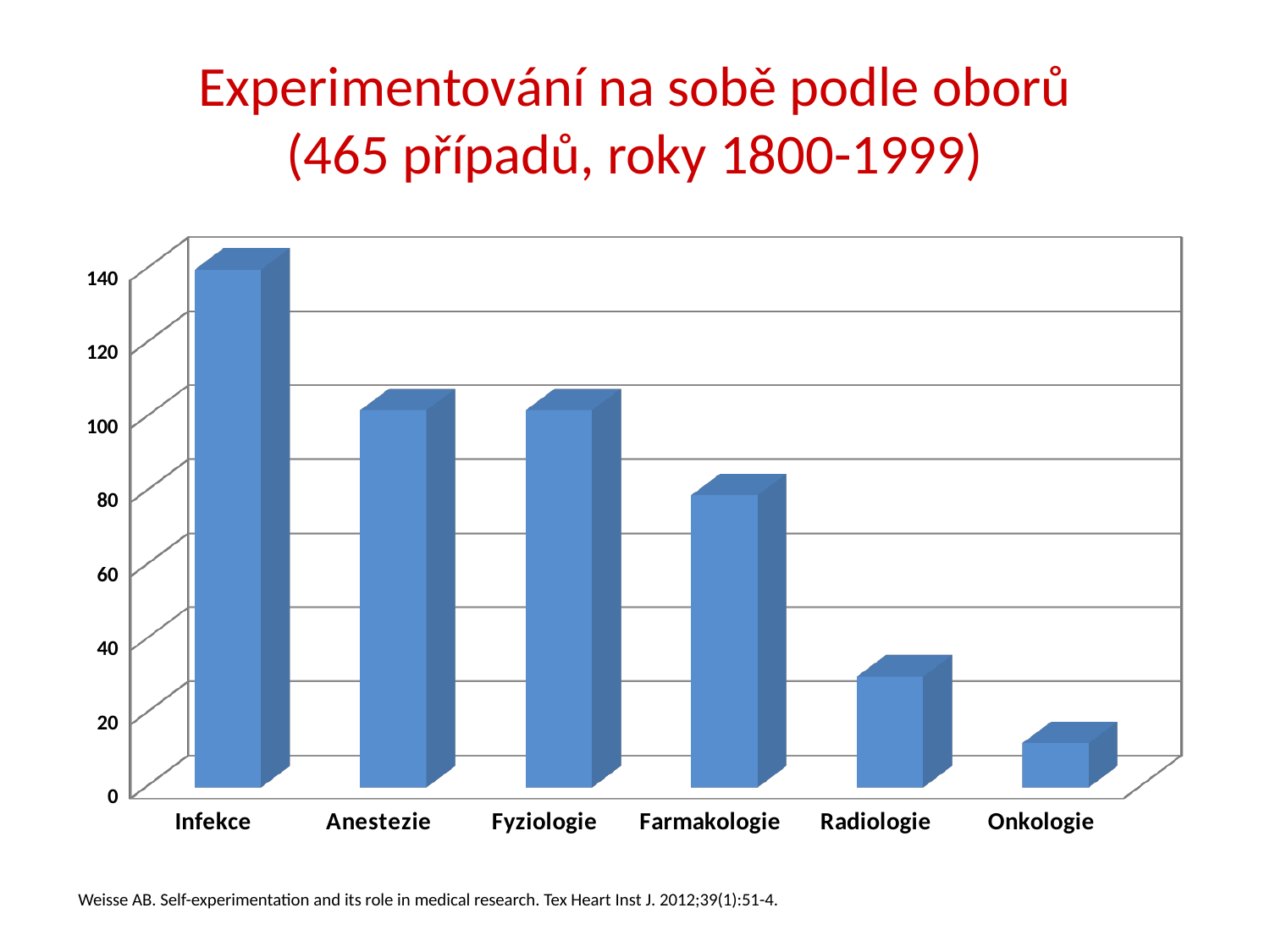
How many categories (fields) are shown on the x axis of the chart? 6 Which field has the lowest bar in the chart? Onkologie What kind of chart is shown on the slide? bar chart Do the bar values rise or fall from left to right along the x axis? fall Is the value for Onkologie greater or less than 20? less What is the title of the slide containing the chart? Experimentování na sobě podle oborů (465 případů, roky 1800-1999) Which is larger, the value for Radiologie or the value for Onkologie? Radiologie Is the value for Infekce greater or less than 120? greater Which field has the highest bar in the chart? Infekce Is the value for Farmakologie greater or less than 100? less Which is larger, the value for Infekce or the value for Farmakologie? Infekce